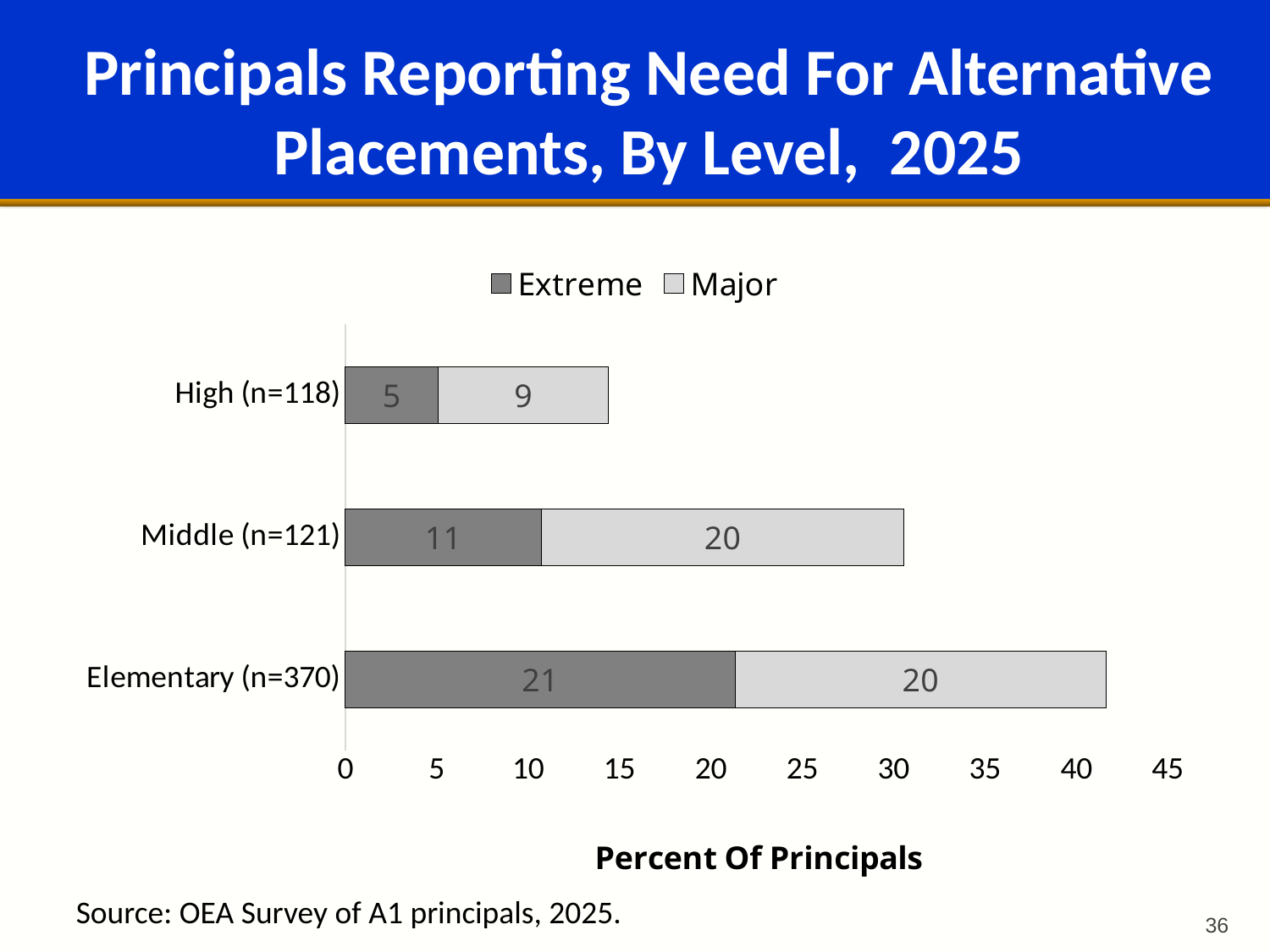
How many series does the legend list? 2 Which is larger, the Major value for Middle (n=121) or the Major value for High (n=118)? Middle (n=121) What is the difference between the Extreme values for Elementary (n=370) and Middle (n=121)? 10 What is the Extreme value for Middle (n=121)? 11 How many levels are shown on the chart? 3 Which level has the highest Extreme value? Elementary (n=370) Which level has the lowest Major value? High (n=118) What is the Extreme value for Elementary (n=370)? 21 What is the total of the stacked bar for Middle (n=121)? 31 What is the Major value for High (n=118)? 9 What kind of chart is shown on the slide? Stacked bar chart What is the total of the stacked bar for Elementary (n=370)? 41